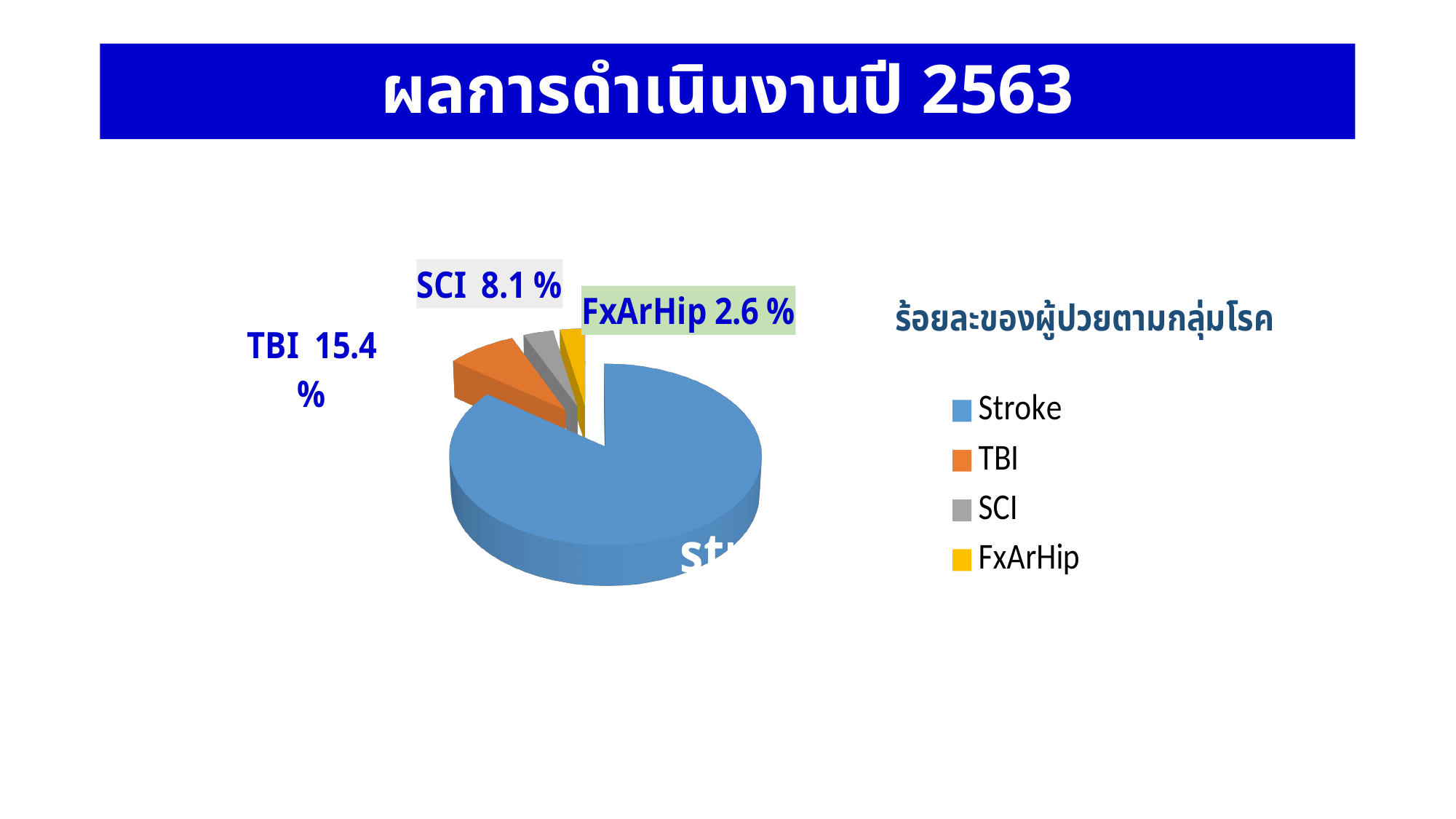
What colour represents Stroke in the pie chart? Blue How many entries does the legend list? 4 What percentage is shown for TBI in the pie chart? 15.4 % Which is larger in the pie chart, TBI or SCI? TBI Which disease group has the largest slice of the pie chart? Stroke What is the difference in percentage points between SCI and FxArHip? 5.5 What is the difference in percentage points between TBI and SCI? 7.3 Which disease group has the smallest slice of the pie chart? FxArHip What type of chart is shown on the slide? Pie chart How many disease groups are shown in the pie chart? 4 What percentage is shown for SCI in the pie chart? 8.1 % What percentage is shown for FxArHip in the pie chart? 2.6 %